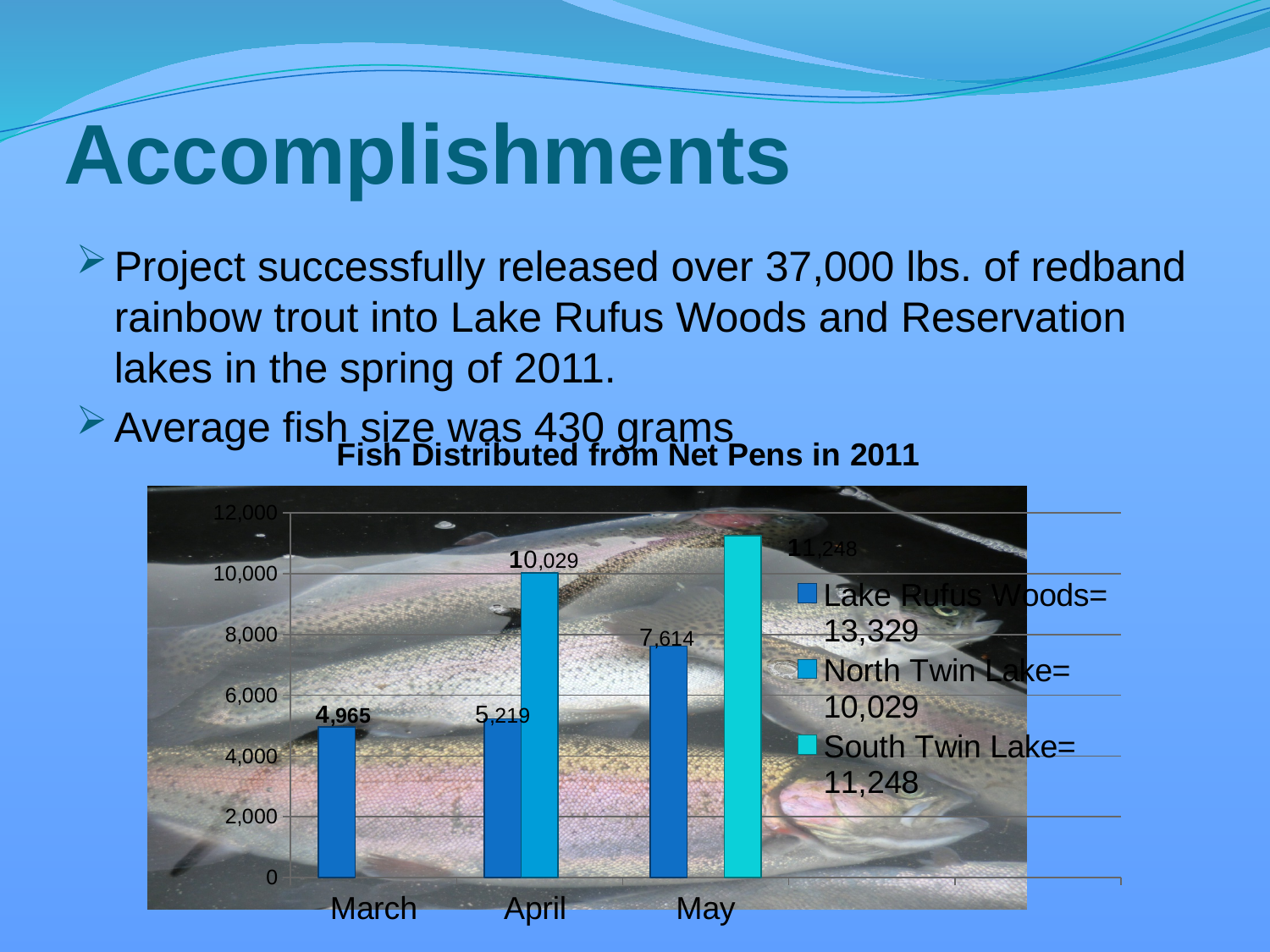
How many months are shown on the x axis of the chart? 3 Which is larger: the South Twin Lake value in May or the North Twin Lake value in April? South Twin Lake in May How many series does the chart legend list? 3 In which month is the Lake Rufus Woods bar highest? May Do the Lake Rufus Woods values rise or fall from March to May? rise How many fish were distributed to Lake Rufus Woods in May? 7,614 How many fish were distributed to Lake Rufus Woods in March? 4,965 How many fish were distributed to South Twin Lake in May? 11,248 In April, how many more fish went to North Twin Lake than to Lake Rufus Woods? 4,810 What is the title of the chart? Fish Distributed from Net Pens in 2011 What kind of chart is shown on the slide? bar chart How many fish were distributed to North Twin Lake in April? 10,029